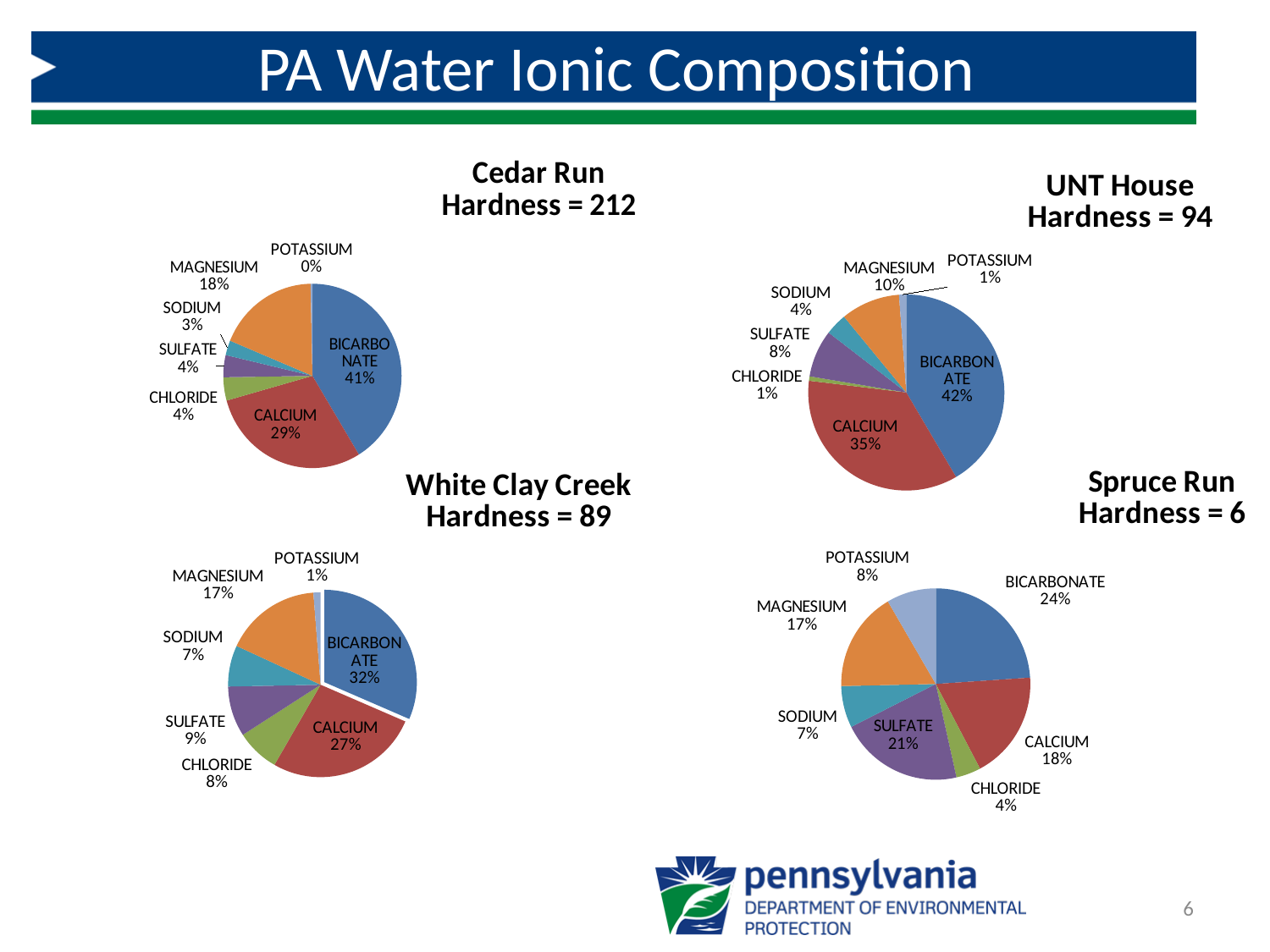
In the UNT House chart, what is the value for Calcium? 35% In the UNT House chart, which ion has the largest share? Bicarbonate What type of chart is used for Cedar Run? Pie chart What hardness value is shown in the title of the White Clay Creek chart? 89 In the White Clay Creek chart, which is larger, Sulfate or Chloride? Sulfate In the Spruce Run chart, what is the value for Sulfate? 21% How many slices does the Spruce Run pie chart have? 7 In the UNT House chart, what is the difference between the Bicarbonate and Calcium shares? 7% In the Cedar Run chart, which ion has the smallest share? Potassium In the Cedar Run chart, what share of the pie is Bicarbonate? 41% In the White Clay Creek chart, what is the value for Magnesium? 17% In the Spruce Run chart, which ion has the largest share? Bicarbonate